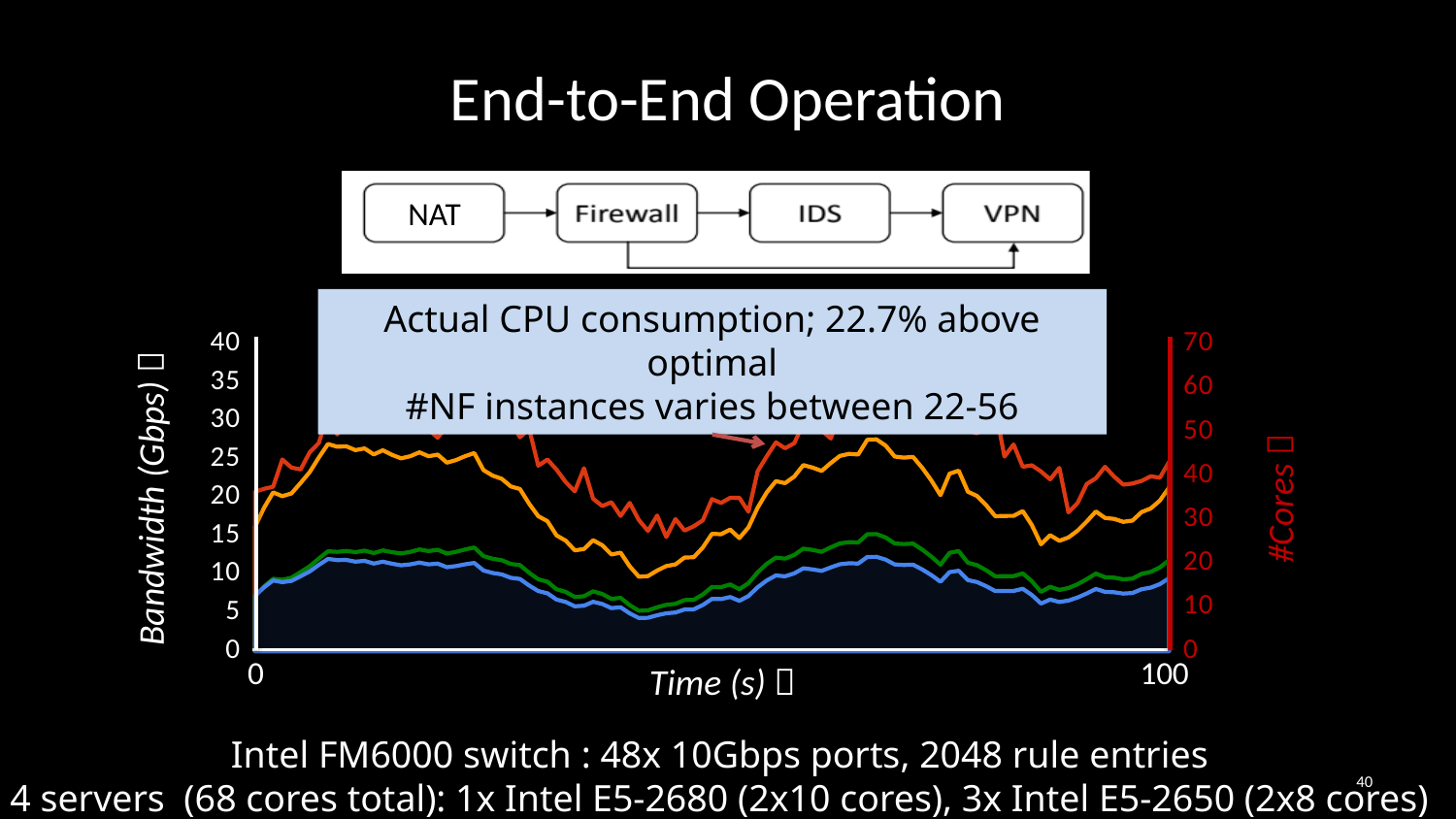
Of the blue line and the orange line, which one is higher across the chart? orange What is the highest tick value shown on the right y-axis? 70 Is the value of the blue line at time 0 greater or less than 10 Gbps? less How many lines are plotted on the chart? 4 Does the blue line rise or fall between time 0 and about 15 s? rise What is the last tick value shown on the Time (s) axis? 100 What is the label of the left y-axis of the chart? Bandwidth (Gbps) What kind of chart is shown on the slide? area chart What is the highest tick value shown on the left y-axis? 40 Is the highest value reached by the blue line greater or less than 15 Gbps? less What is the label of the right y-axis of the chart? #Cores Which of the bandwidth lines (blue, green, orange) stays lowest across the chart? blue